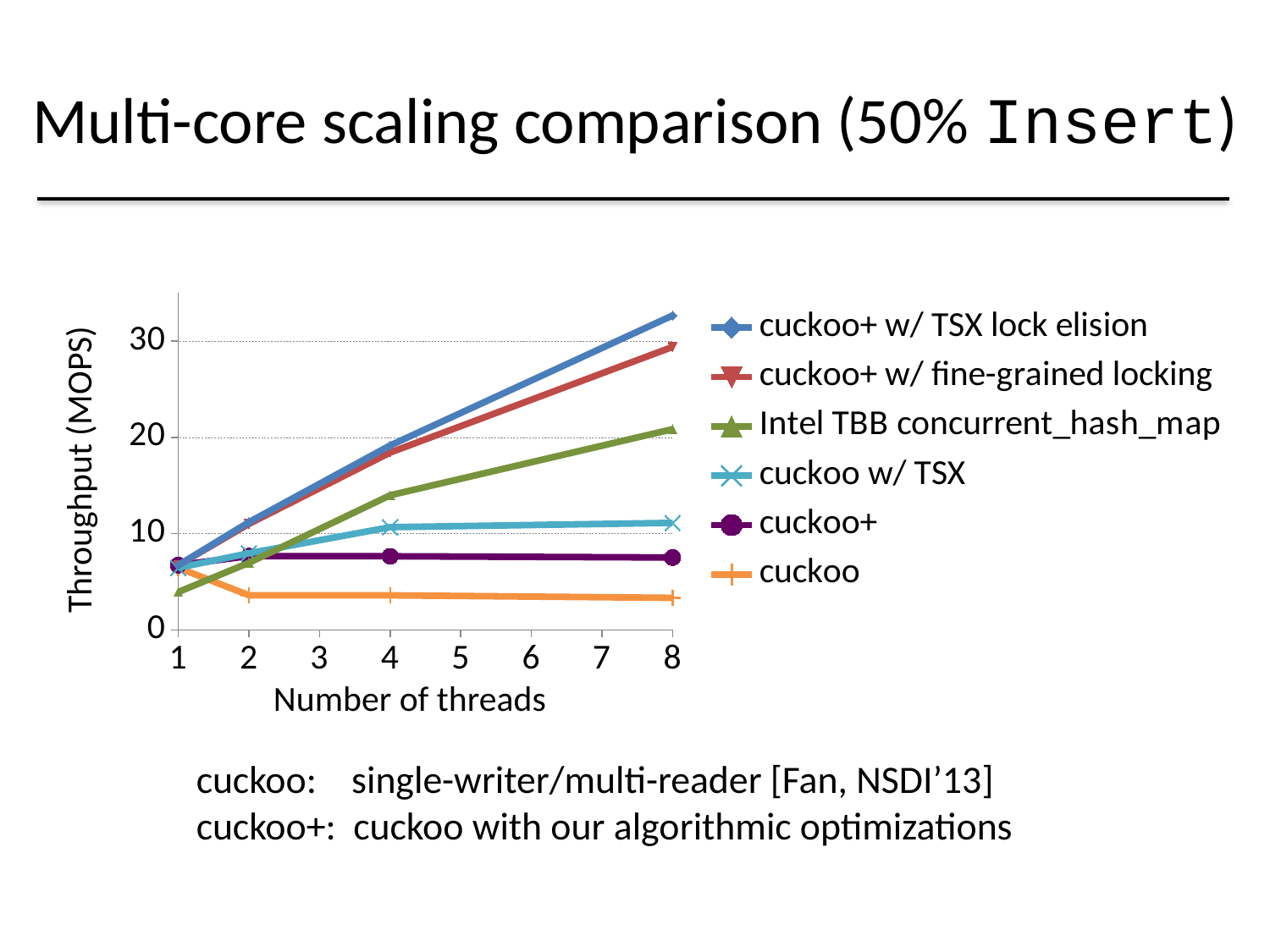
Is the throughput of cuckoo+ at 8 threads greater or less than 10 MOPS? less How many series does the legend list? 6 What kind of chart is shown on the slide? line chart Which series has the lowest throughput at 8 threads? cuckoo What is the label of the y axis? Throughput (MOPS) At 4 threads, which has higher throughput: Intel TBB concurrent_hash_map or cuckoo w/ TSX? Intel TBB concurrent_hash_map Is the throughput of Intel TBB concurrent_hash_map at 8 threads greater or less than 20 MOPS? greater Is the throughput of cuckoo+ w/ TSX lock elision at 8 threads greater or less than 30 MOPS? greater Which series has the highest throughput at 8 threads? cuckoo+ w/ TSX lock elision Does the throughput of cuckoo+ w/ TSX lock elision rise or fall as the number of threads increases? rise How many thread counts are plotted as data points for each series? 4 Does the throughput of cuckoo rise or fall as the number of threads increases? fall